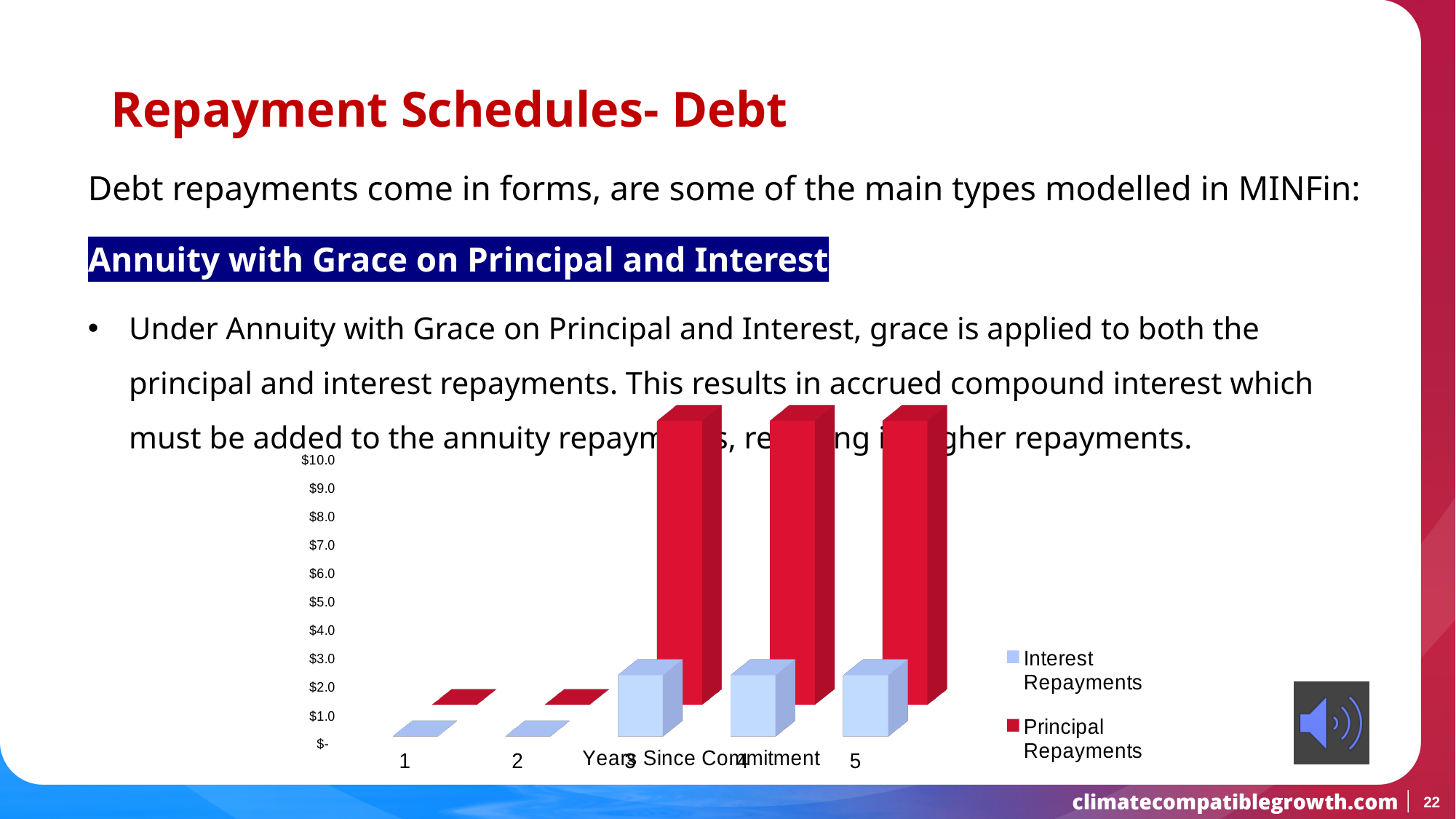
What is the title of the x axis of the chart? Years Since Commitment Is the value for Principal Repayments in year 3 greater or less than $5.0? greater How many categories (years) are shown on the x axis of the chart? 5 Is the value for Principal Repayments in year 5 greater or less than $8.0? greater In year 4, which is larger: Principal Repayments or Interest Repayments? Principal Repayments Which series is shown in red in the chart? Principal Repayments How many series does the chart's legend list? 2 Is the value for Interest Repayments in year 1 greater or less than $1.0? less Do the Principal Repayments values rise or fall from year 1 to year 5? rise What kind of chart is shown on the slide? bar chart